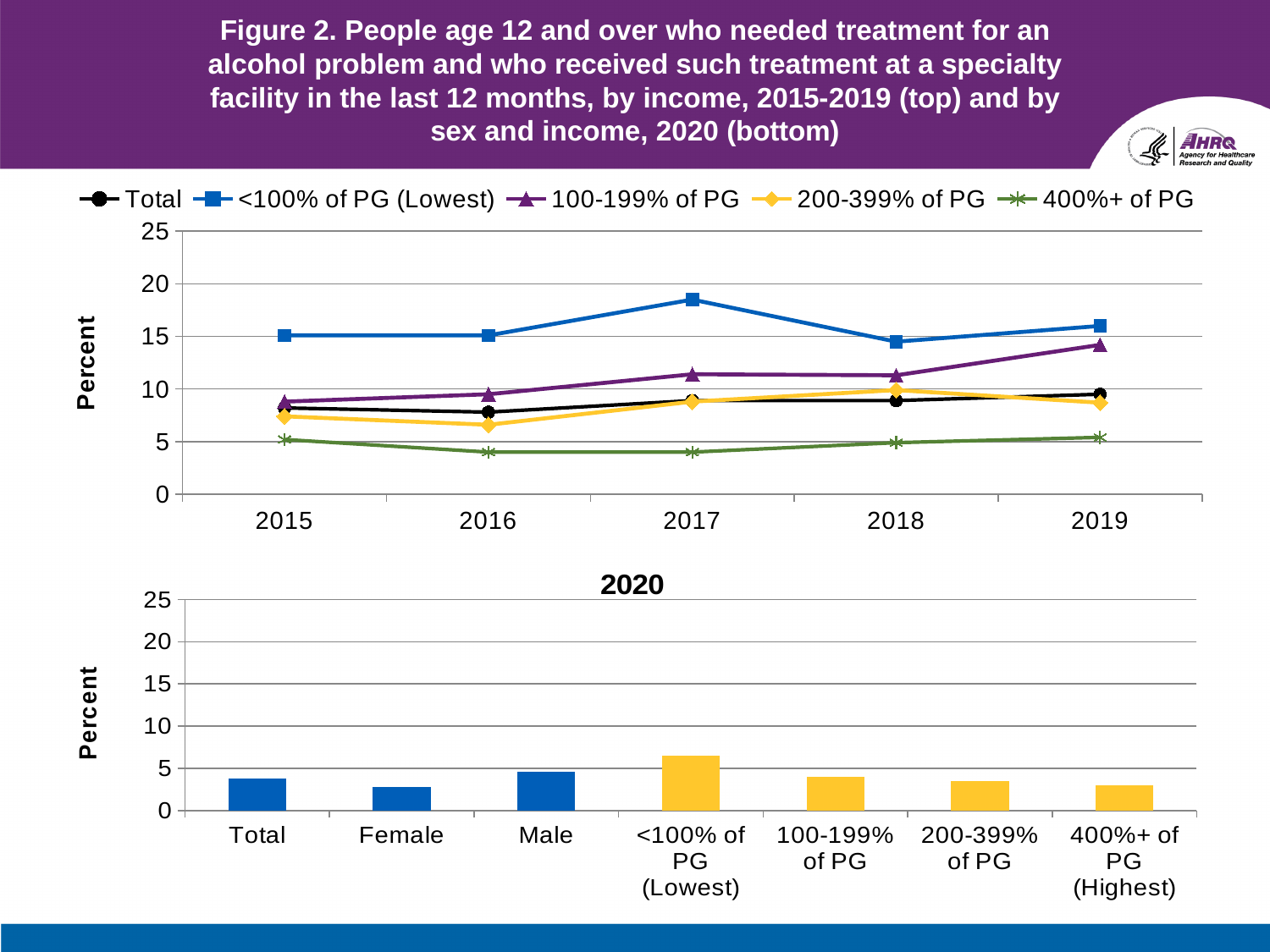
In the top chart, which income group has the highest value in 2017? <100% of PG (Lowest) What kind of chart is the top chart (2015-2019)? line chart In the bottom chart (2020), which is larger, the value for Male or the value for Female? Male How many years are plotted on the x axis of the top chart? 5 In the top chart, is the value for 400%+ of PG in 2016 greater or less than 5? less In the top chart, is the value for <100% of PG (Lowest) in 2017 greater or less than 15? greater In the top chart, which income group has the lowest value in 2016? 400%+ of PG In the top chart, does the value for 100-199% of PG rise or fall from 2015 to 2019? rise What kind of chart is the bottom chart titled 2020? bar chart How many categories are shown on the x axis of the bottom chart (2020)? 7 How many series does the legend of the top chart list? 5 In the bottom chart (2020), which category has the highest value? <100% of PG (Lowest)